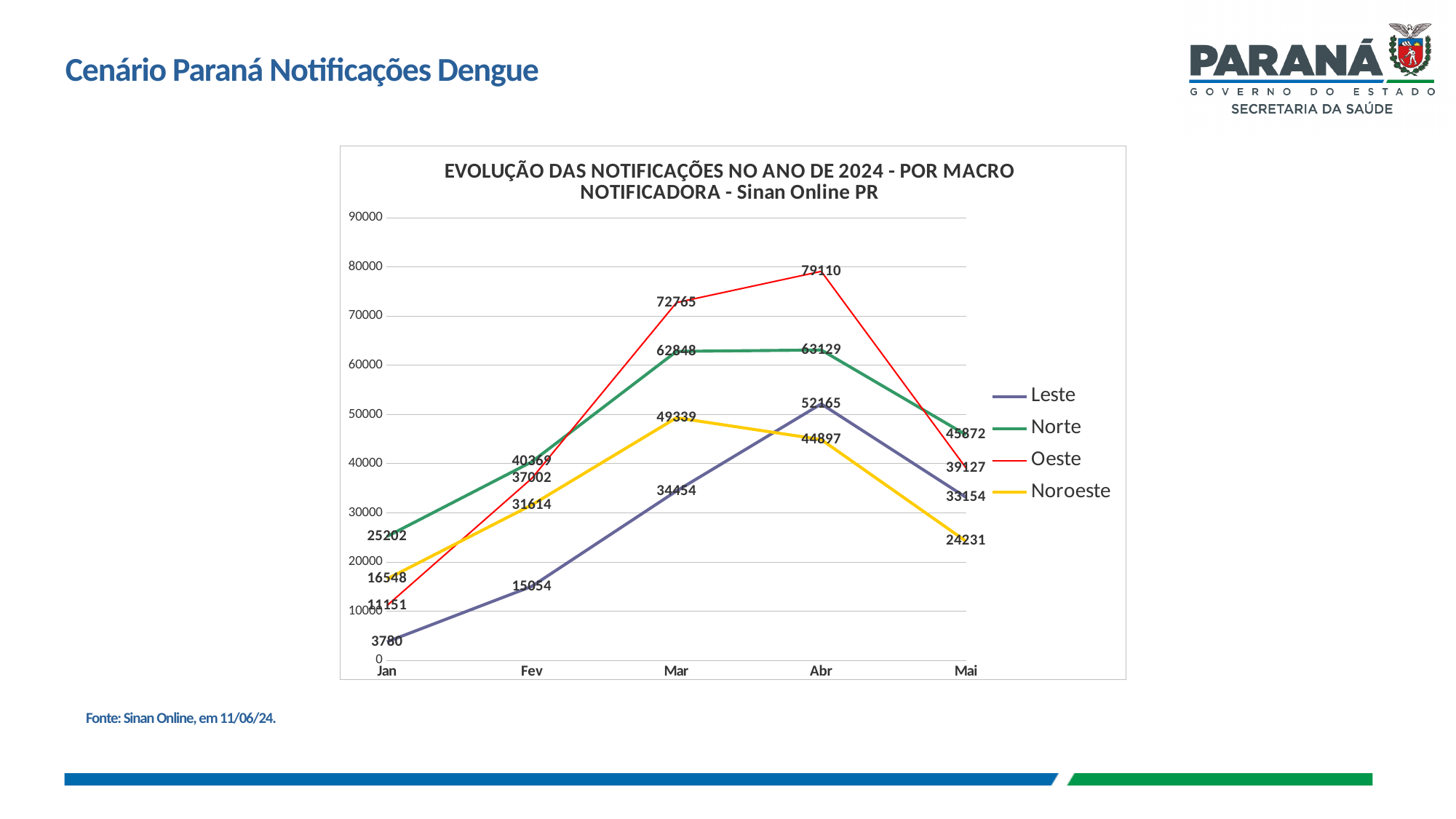
What is the difference between the Oeste values in Abr and Mar? 6345 What is the value for Leste in Jan? 3780 In Mar, which is larger: the value for Norte or the value for Leste? Norte Which series has the highest value in Abr? Oeste Which series has the lowest value in Jan? Leste What is the value for Noroeste in Mar? 49339 Which series is drawn in yellow? Noroeste How many series does the legend list? 4 How many months are plotted along the x axis? 5 What is the value for Oeste in Abr? 79110 What kind of chart is shown on the slide? line chart Does the Leste line rise or fall from Jan to Abr? rises